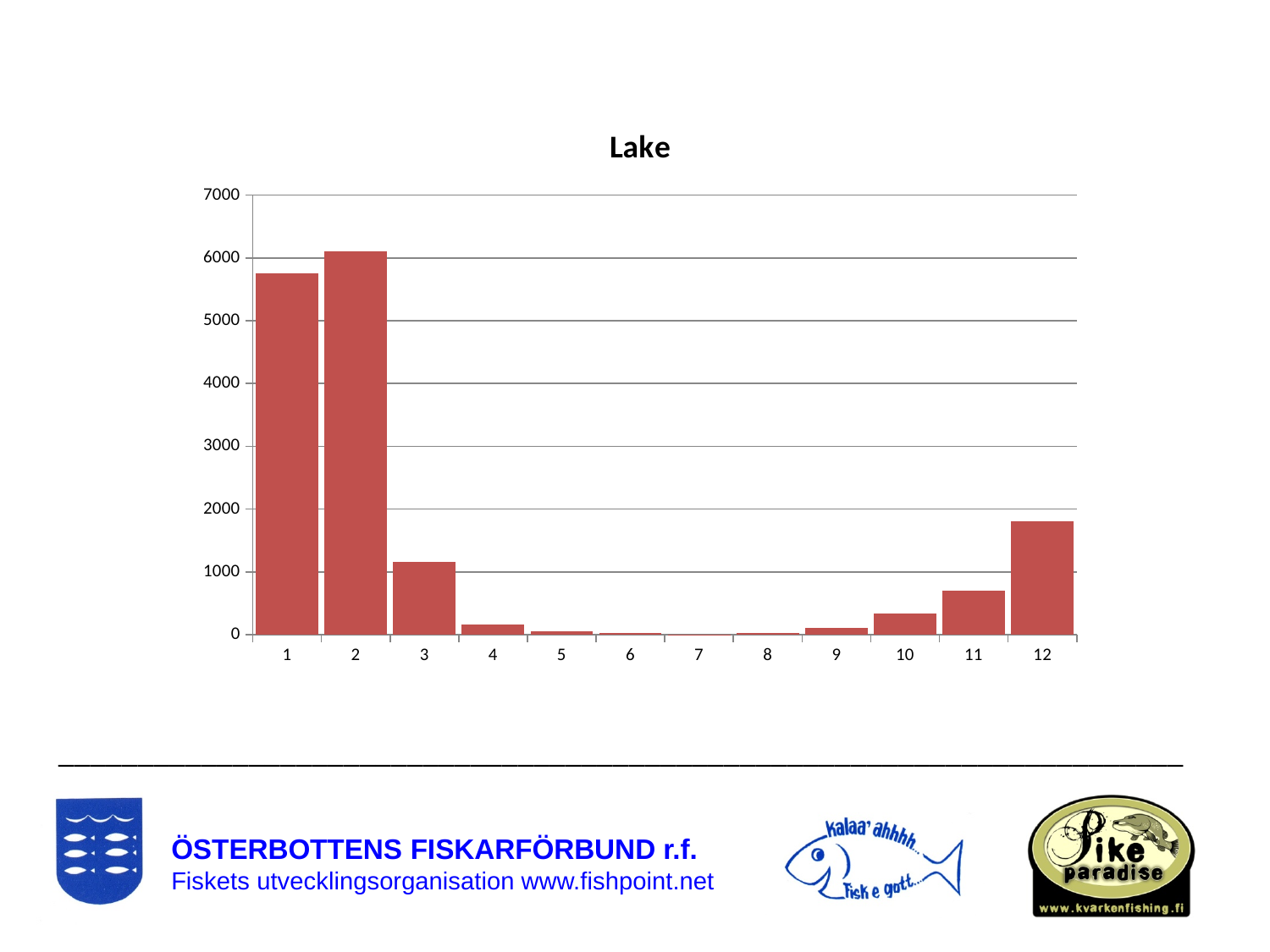
What is the title of the chart? Lake Which category has the highest bar in the chart? 2 What kind of chart is shown on the slide? bar chart Is the value for category 1 greater or less than 5000? greater Do the values rise or fall from category 2 to category 7? fall How many categories are shown on the x axis of the chart? 12 Which is larger, the value for category 12 or the value for category 3? 12 Is the value for category 12 greater or less than 2000? less Is the value for category 11 greater or less than 1000? less Which is larger, the value for category 10 or the value for category 11? 11